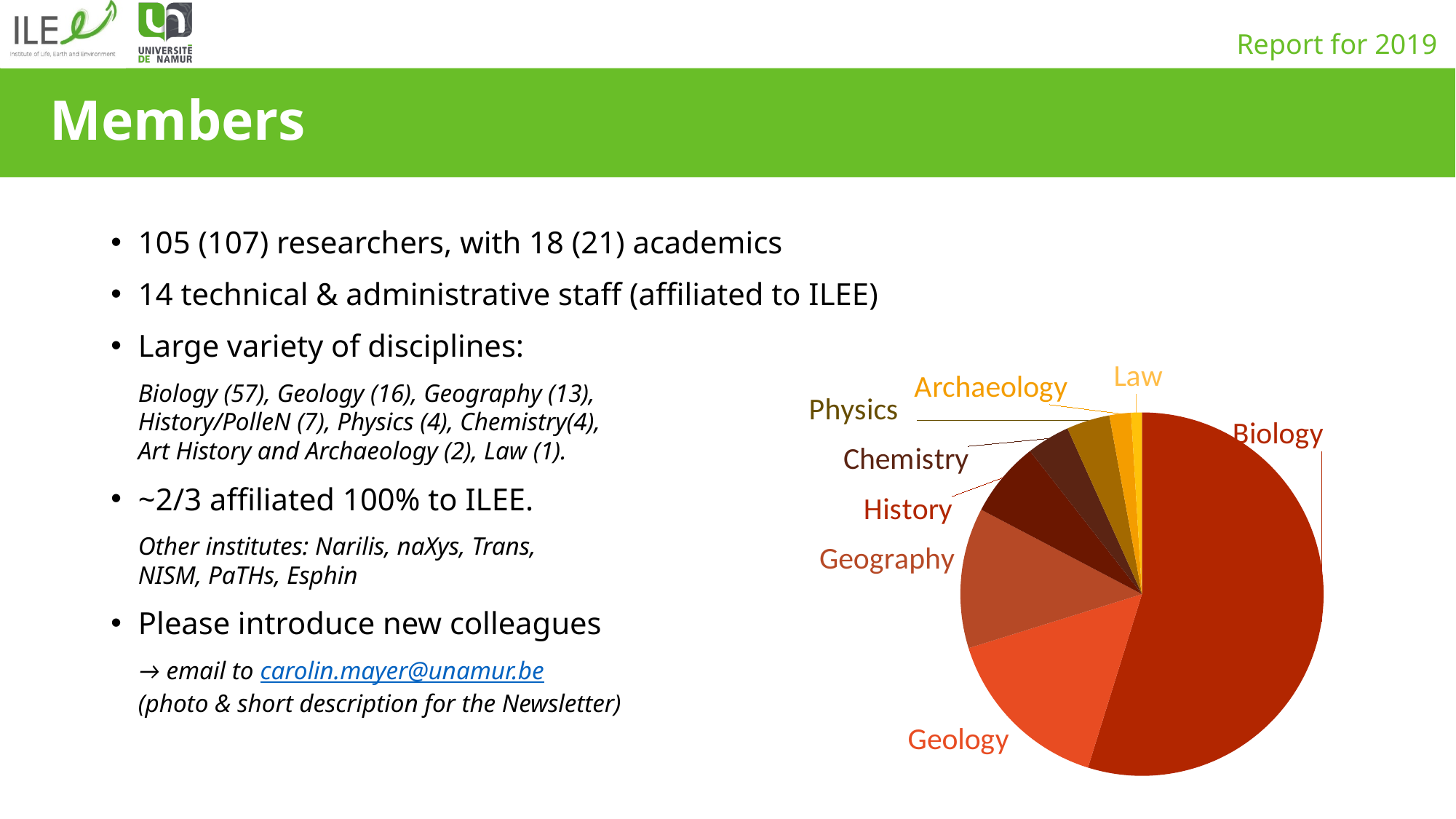
What kind of chart is shown on the slide? pie chart Which discipline has the largest slice in the pie chart? Biology According to the slide, how many researchers are in Law? 1 Which slice of the pie chart is labelled in yellow at the top? Law Which discipline has the smallest slice in the pie chart? Law How many slices does the pie chart have? 8 Which slice is larger in the pie chart, Biology or Geology? Biology According to the slide, how many researchers are in Biology? 57 Does the Biology slice account for more or less than half of the pie chart? more Which slice is larger in the pie chart, Geology or Geography? Geology What is the difference between the number of researchers in Biology and in Geology, as given on the slide? 41 According to the slide, how many researchers are in Geology? 16